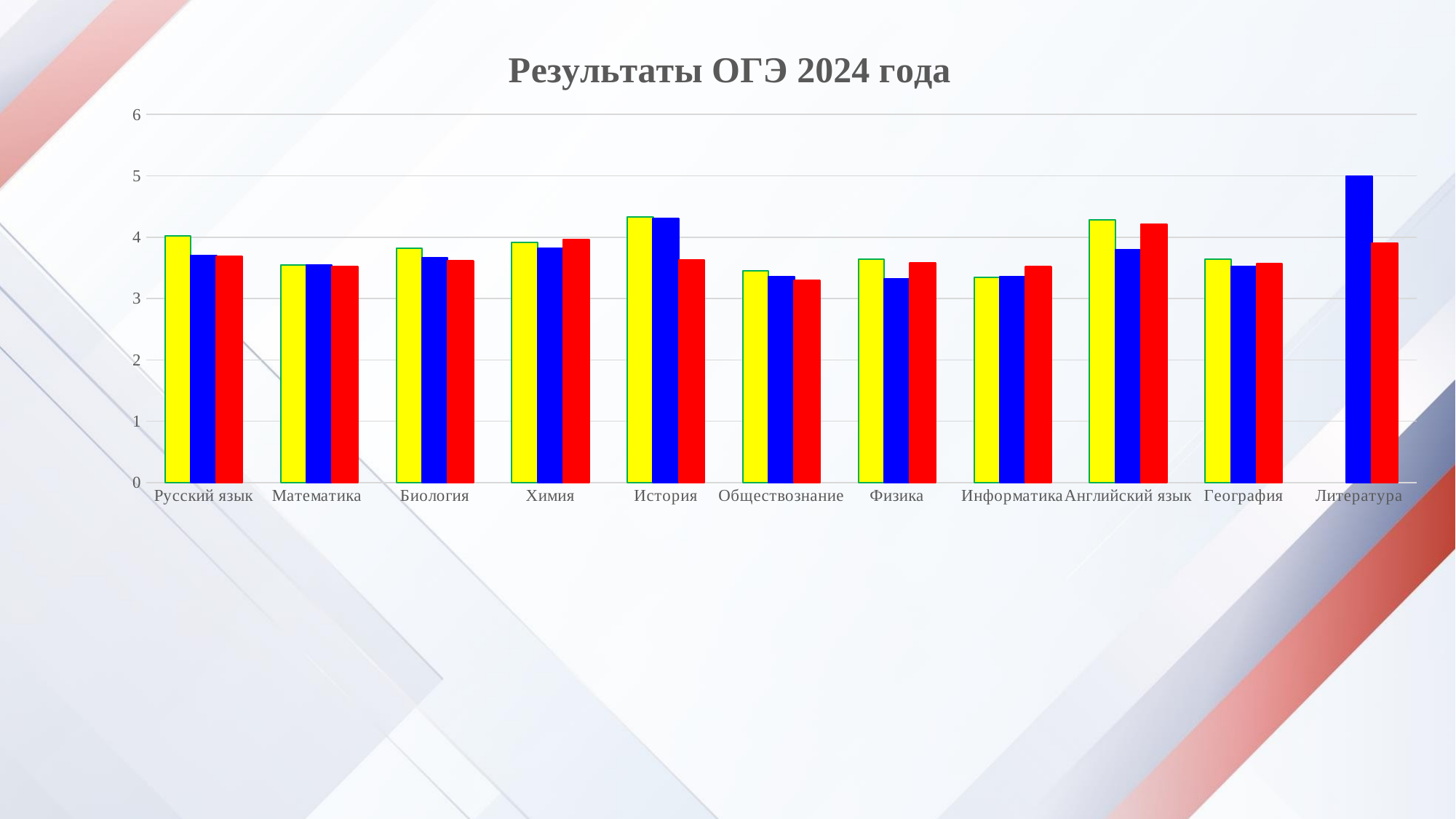
Is the blue bar for Литература greater or less than 4? greater For История, which bar is taller, the yellow one or the red one? Yellow Is the yellow bar for Математика greater or less than 4? less What is the title of the chart? Результаты ОГЭ 2024 года How many subject categories are shown on the x axis? 11 What kind of chart is shown on the slide? Bar chart For Литература, which bar is taller, the blue one or the red one? Blue Is the yellow bar for История greater or less than 4? greater Which category has the tallest blue bar? Литература What colours are the bars in the chart? Yellow, blue and red